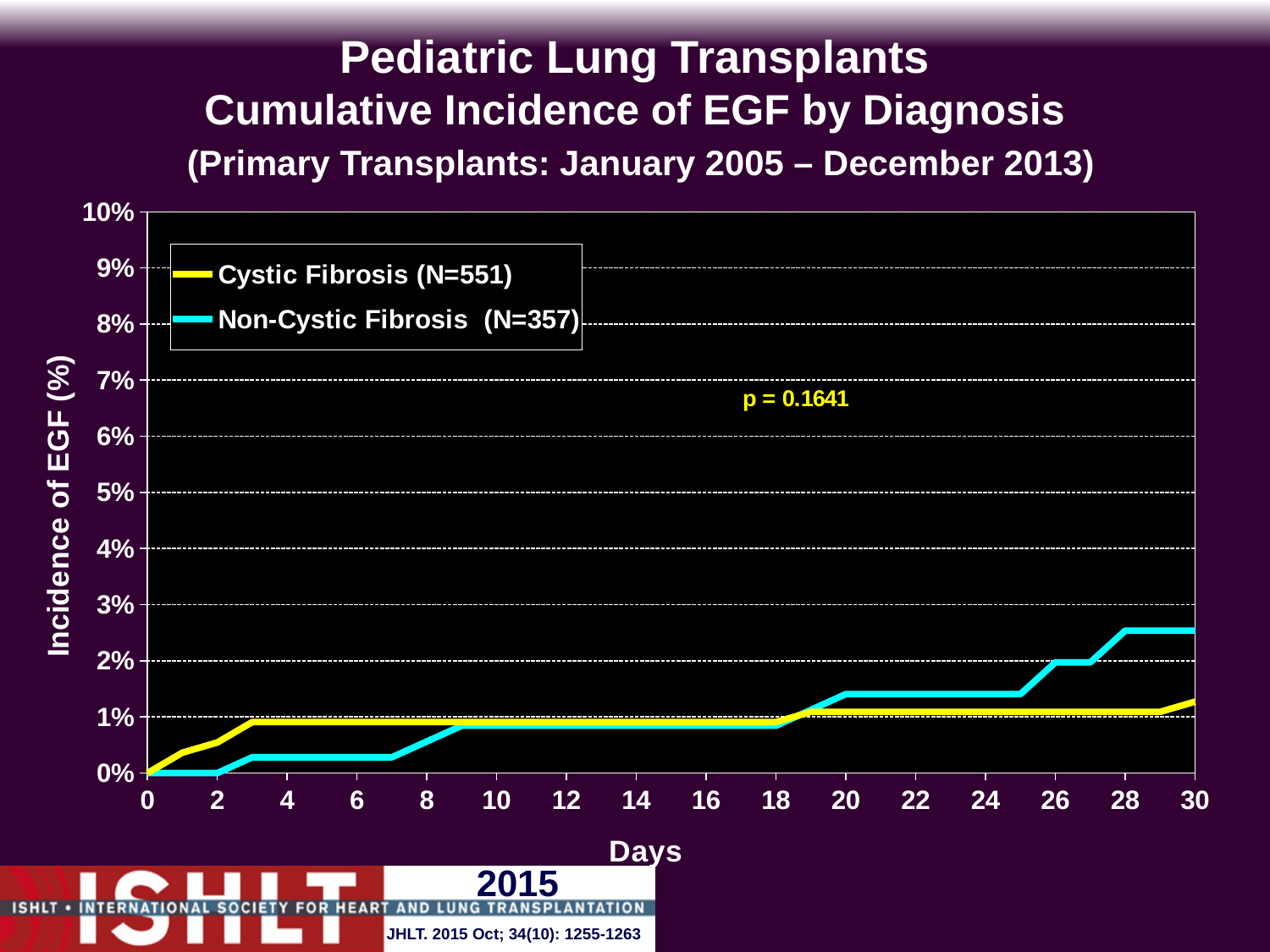
Is the value for Non-Cystic Fibrosis at day 5 greater or less than 1%? less Is the value for Non-Cystic Fibrosis at day 30 greater or less than 2%? greater What kind of chart is shown on the slide? line chart What is the N for the Cystic Fibrosis series in the legend? N=551 Is the value for Non-Cystic Fibrosis at day 30 greater or less than 3%? less Does the cumulative incidence of EGF for Non-Cystic Fibrosis rise or fall as days increase? rise Which series has the higher cumulative incidence of EGF at day 30? Non-Cystic Fibrosis How many series does the legend list? 2 What p-value is printed on the chart? p = 0.1641 Which series has the higher cumulative incidence of EGF at day 5? Cystic Fibrosis Which series reaches the highest cumulative incidence of EGF on the chart? Non-Cystic Fibrosis